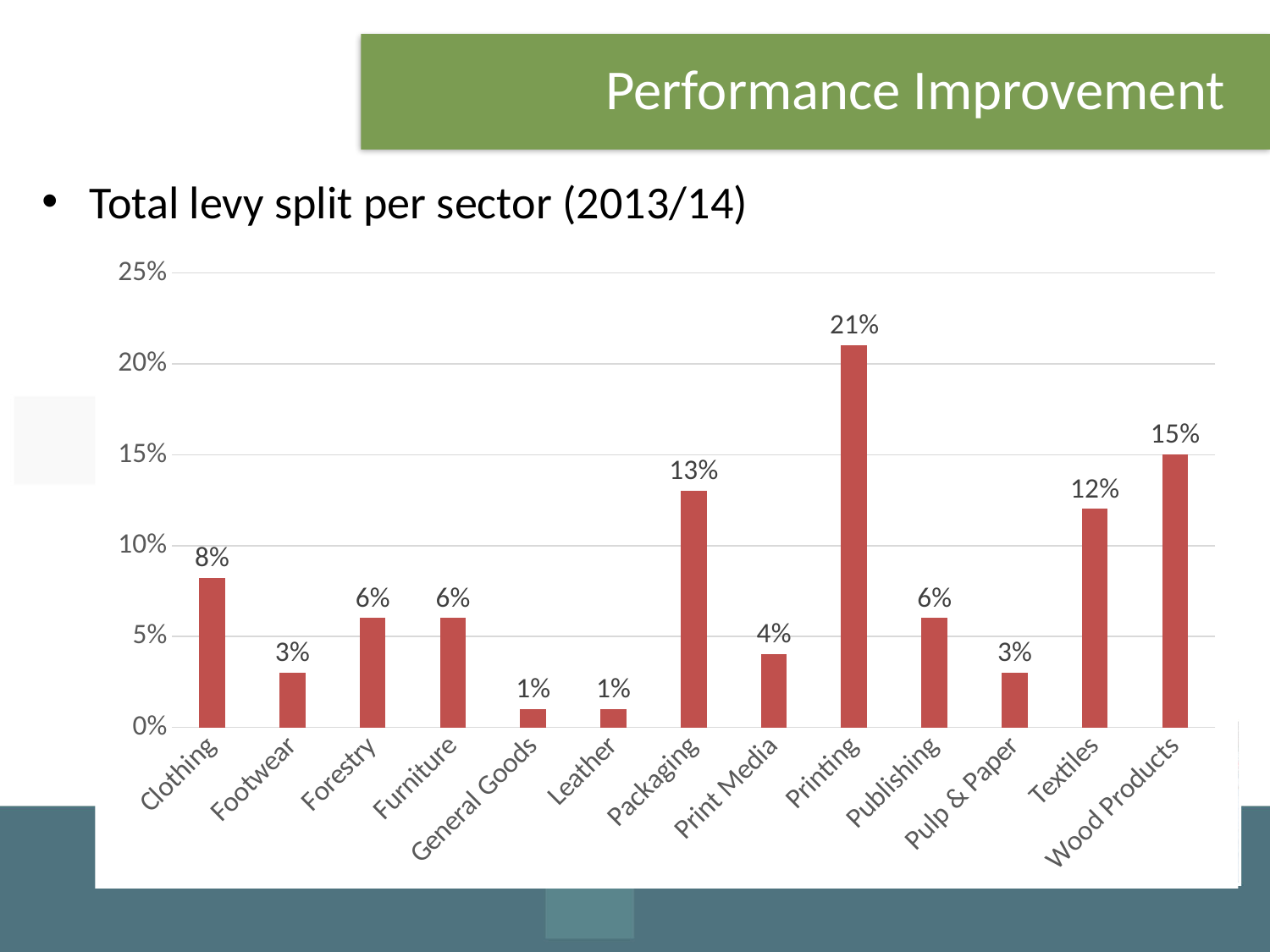
Which sector has the highest value? Printing What is the highest value shown on the y axis? 25% Is the value for Textiles greater or less than 10%? greater What kind of chart is shown on the slide? Bar chart What is the value for Wood Products? 15% What is the value for Packaging? 13% What is the value for Printing? 21% How many sectors are shown on the x axis? 13 Which is larger, the value for Packaging or the value for Wood Products? Wood Products What is the difference between the values for Printing and Textiles? 9% What is the difference between the values for Clothing and Footwear? 5% What is the value for Clothing? 8%